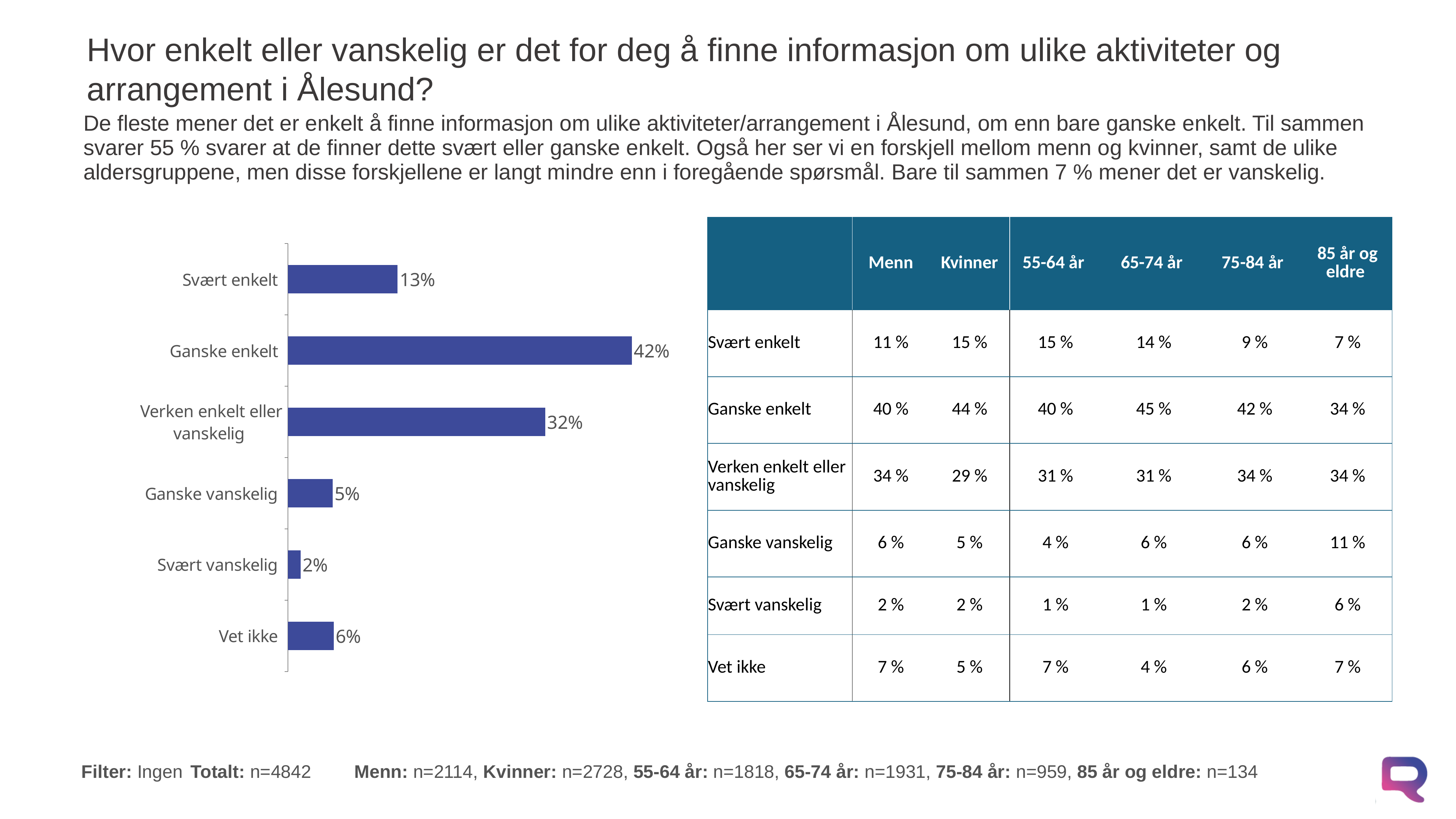
What is the value for "Ganske enkelt" in the bar chart? 42% Which is larger in the bar chart: "Ganske vanskelig" or "Vet ikke"? Vet ikke Which category has the lowest value in the bar chart? Svært vanskelig What colour are the bars in the bar chart? Blue What is the difference between the values for "Ganske vanskelig" and "Svært vanskelig" in the bar chart? 3% What kind of chart is shown on the slide? Bar chart How many categories are shown in the bar chart? 6 What is the value for "Vet ikke" in the bar chart? 6% Which category has the highest value in the bar chart? Ganske enkelt What is the combined value of "Svært enkelt" and "Ganske enkelt" in the bar chart? 55% What is the value for "Svært enkelt" in the bar chart? 13% What is the difference between the values for "Ganske enkelt" and "Verken enkelt eller vanskelig" in the bar chart? 10%